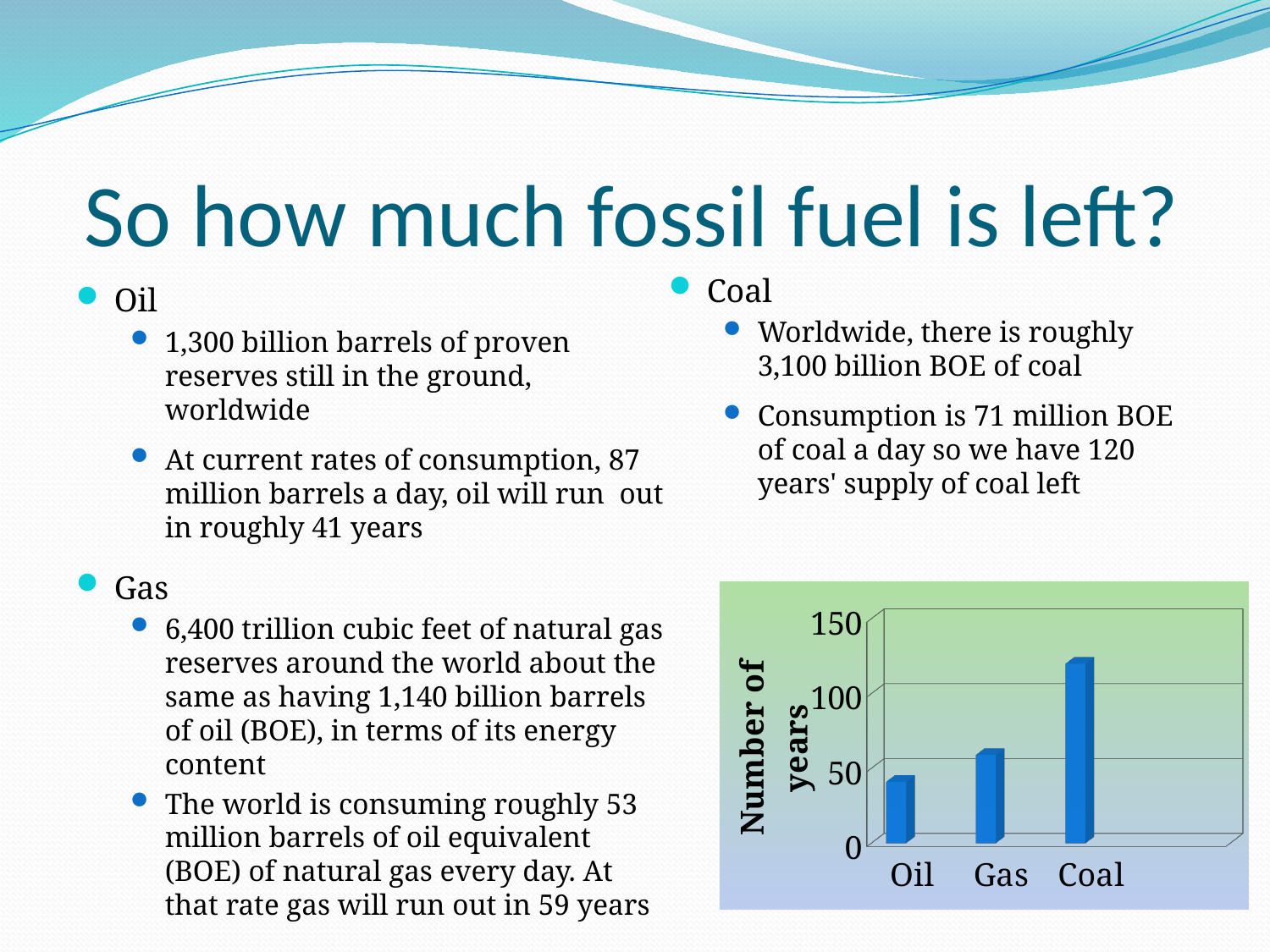
Which category has the highest bar on the chart? Coal Is the value for Coal greater or less than 150? less Which is larger on the chart, the value for Gas or the value for Oil? Gas Is the value for Coal greater or less than 100? greater Is the value for Oil greater or less than 50? less What kind of chart is shown on the slide? bar chart How many categories are plotted on the chart? 3 Do the bar values rise or fall from left to right across the chart? rise Which category has the lowest bar on the chart? Oil What is the label on the vertical axis of the chart? Number of years